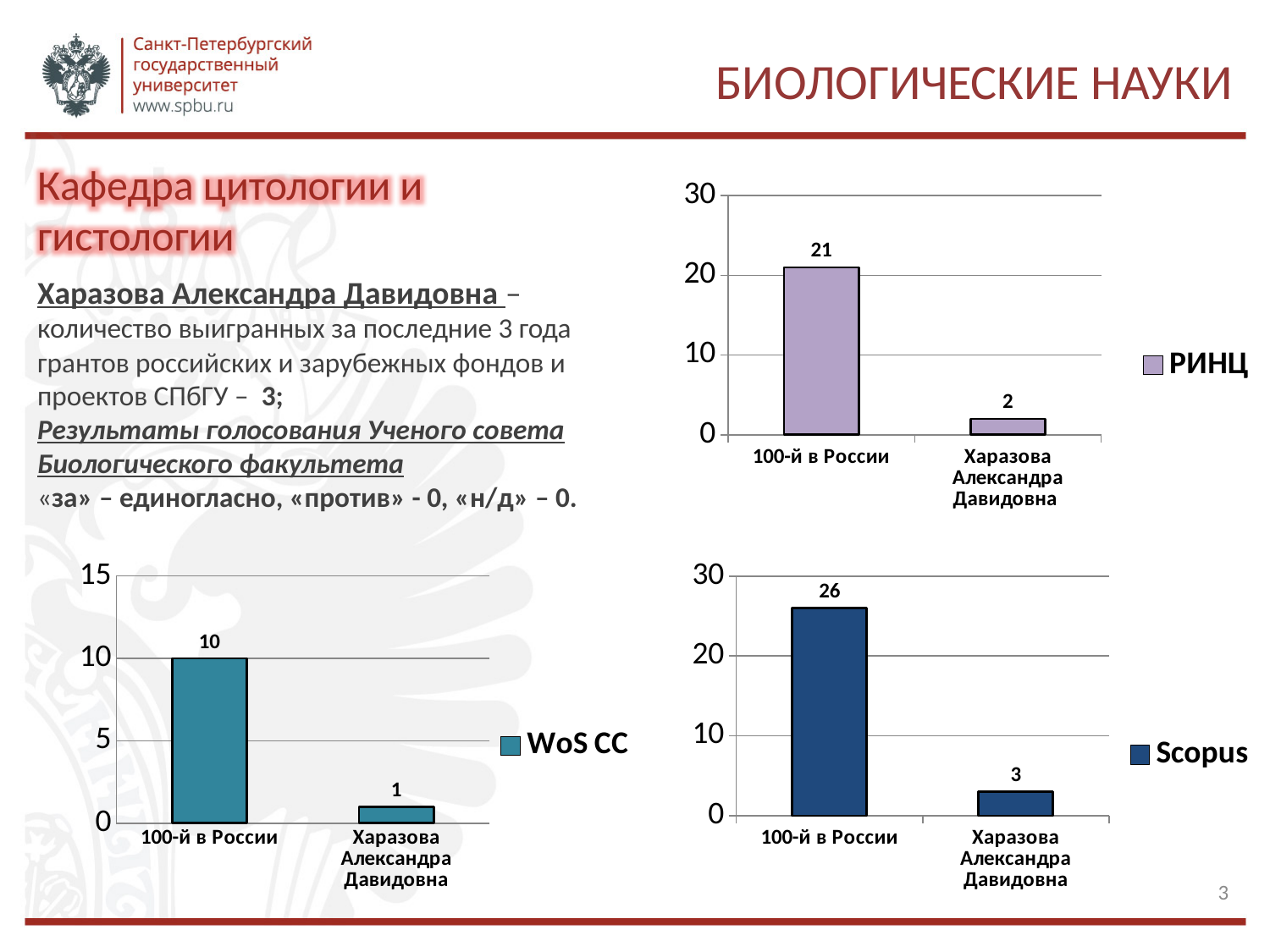
In the Scopus chart (bottom right), what is the value for Харазова Александра Давидовна? 3 What kind of chart is the WoS CC chart (bottom left)? bar chart In the WoS CC chart (bottom left), what is the value for Харазова Александра Давидовна? 1 In the Scopus chart (bottom right), what is the difference between the values for 100-й в России and Харазова Александра Давидовна? 23 In the WoS CC chart (bottom left), which category has the highest value? 100-й в России In the Scopus chart (bottom right), what is the value for 100-й в России? 26 In the Scopus chart (bottom right), is the value for 100-й в России greater or less than 20? greater In the РИНЦ chart (top right), what is the value for 100-й в России? 21 In the РИНЦ chart (top right), what is the difference between the values for 100-й в России and Харазова Александра Давидовна? 19 In the РИНЦ chart (top right), what is the value for Харазова Александра Давидовна? 2 How many categories are shown in the Scopus chart (bottom right)? 2 In the WoS CC chart (bottom left), what is the value for 100-й в России? 10